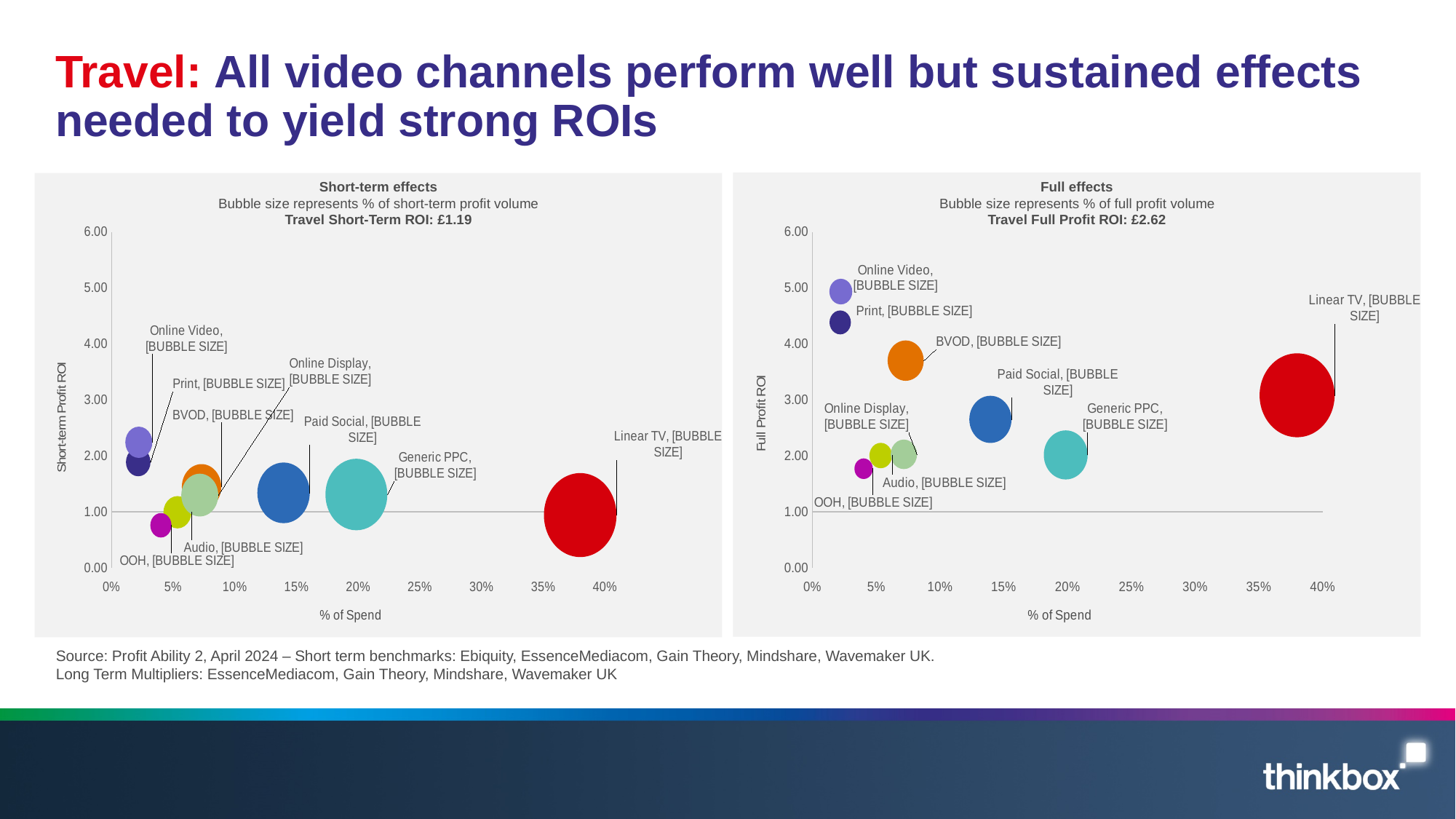
In the Full effects chart, is the Full Profit ROI for BVOD greater or less than 3.00? greater What Travel Full Profit ROI is stated in the title of the Full effects chart? £2.62 What Travel Short-Term ROI is stated in the title of the Short-term effects chart? £1.19 In the Short-term effects chart, is the Short-term Profit ROI for OOH greater or less than 1.00? less What kind of chart is the Short-term effects chart? bubble chart In the Full effects chart, which channel has the highest Full Profit ROI? Online Video In the Full effects chart, which channel has the lowest Full Profit ROI? OOH In the Short-term effects chart, which channel has the lowest Short-term Profit ROI? OOH In the Full effects chart, which has the larger Full Profit ROI, Online Video or Linear TV? Online Video In the Short-term effects chart, how many channel bubbles are plotted? 9 In the Full effects chart, is the Full Profit ROI for Online Video greater or less than 4.00? greater In the Short-term effects chart, which channel has the highest Short-term Profit ROI? Online Video